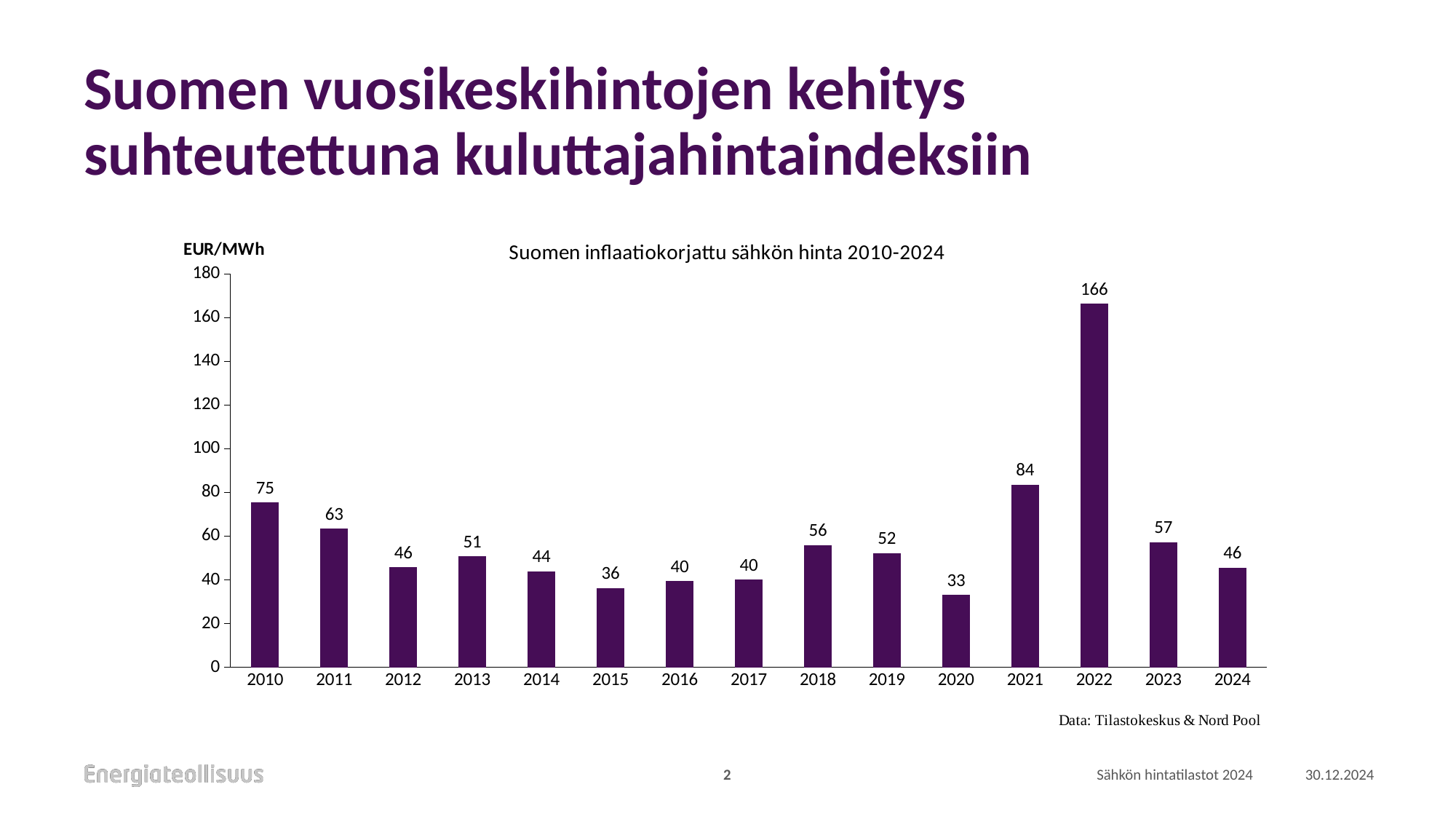
Which is larger, the value for 2011 or the value for 2023? 2011 How many years are shown on the x axis? 15 Do the values rise or fall from 2010 to 2015? fall What is the value for 2010? 75 What is the title of the chart? Suomen inflaatiokorjattu sähkön hinta 2010-2024 Which year has the lowest value? 2020 What is the value for 2020? 33 What kind of chart is this? bar chart Which year has the highest value? 2022 Is the value for 2021 greater or less than 100? less What is the value for 2022? 166 What is the difference between the values for 2022 and 2021? 82